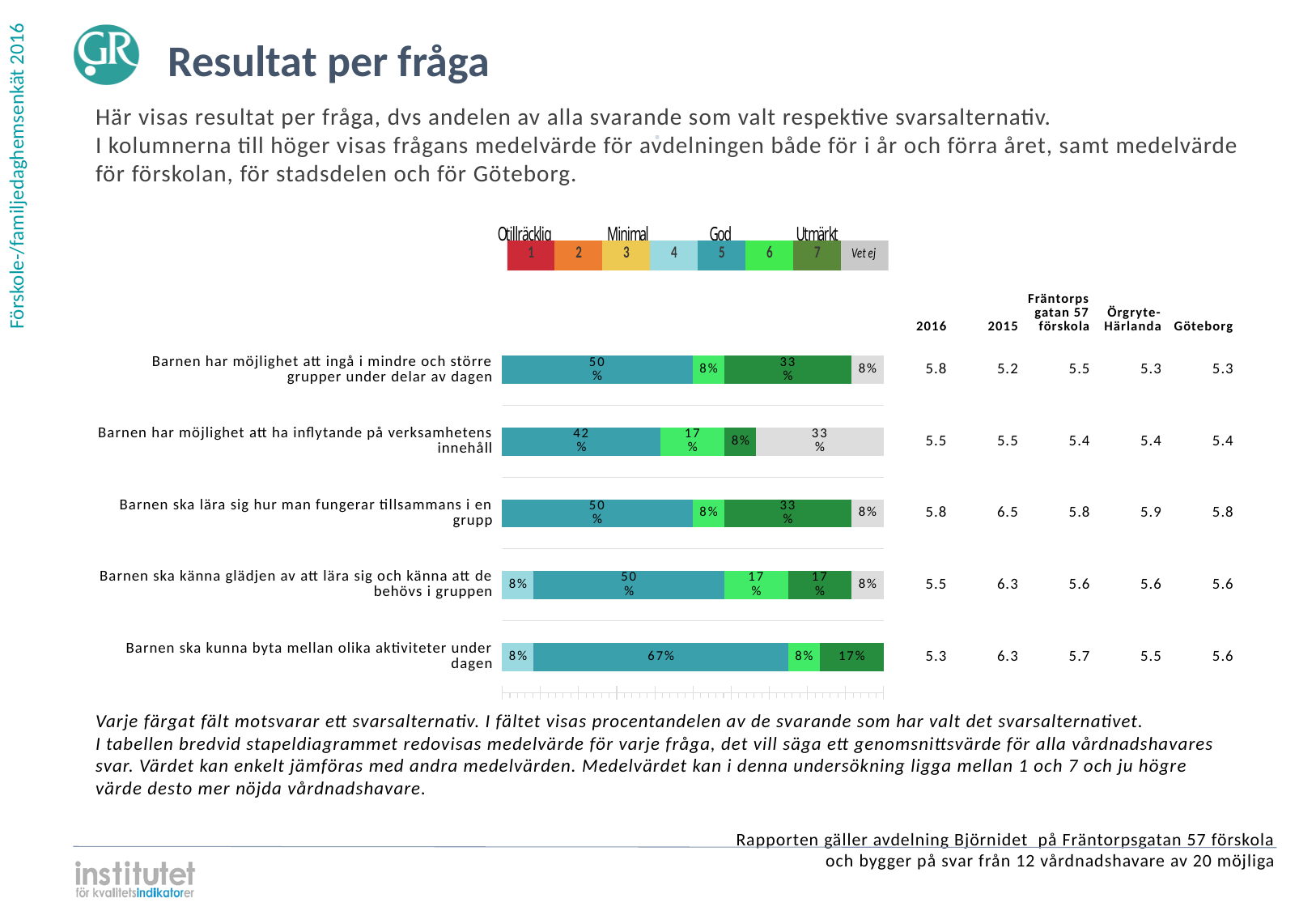
What colour represents answer option 1 (Otillräcklig) in the legend? Red For 'Barnen ska känna glädjen av att lära sig och känna att de behövs i gruppen', which is larger: the share for option 5 or the share for option 6? Option 5 What kind of chart is shown on the slide? Stacked bar chart What is the 2016 mean value shown for 'Barnen ska lära sig hur man fungerar tillsammans i en grupp'? 5.8 What percentage chose option 7 (dark green) for 'Barnen har möjlighet att ingå i mindre och större grupper under delar av dagen'? 33% How many answer options does the legend above the chart list, including 'Vet ej'? 8 How many questions (categories) are plotted in the bar chart? 5 Which question has the largest share of respondents choosing option 5 (teal)? Barnen ska kunna byta mellan olika aktiviteter under dagen Which question has the largest 'Vet ej' share? Barnen har möjlighet att ha inflytande på verksamhetens innehåll What percentage chose 'Vet ej' for 'Barnen har möjlighet att ha inflytande på verksamhetens innehåll'? 33% What percentage of respondents chose option 5 (God, teal) for 'Barnen ska kunna byta mellan olika aktiviteter under dagen'? 67% What is the difference between the option 5 share for 'Barnen ska kunna byta mellan olika aktiviteter under dagen' (67%) and for 'Barnen ska lära sig hur man fungerar tillsammans i en grupp' (50%)? 17 percentage points